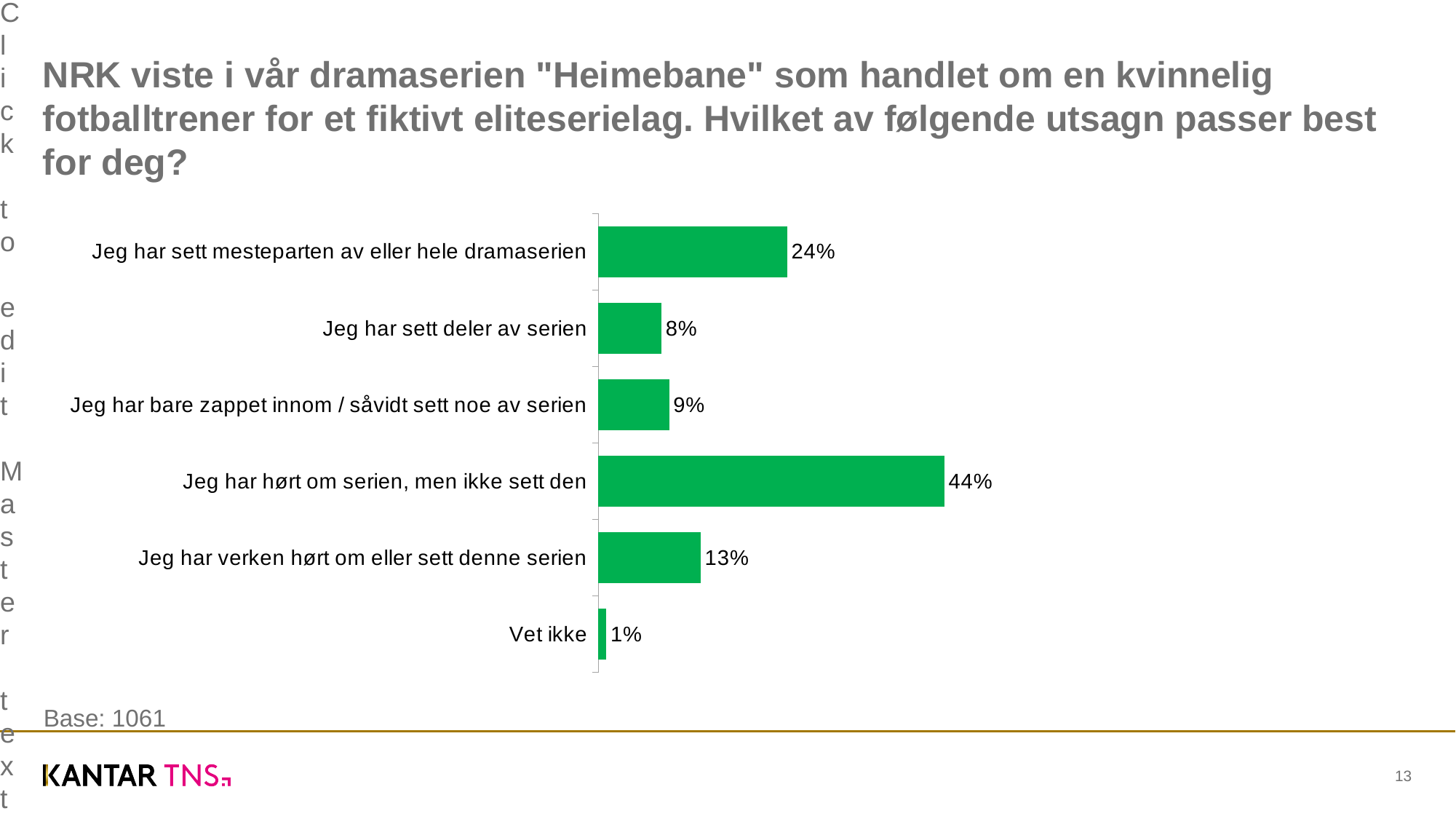
How many categories are shown in the chart? 6 What kind of chart is shown on the slide? Bar chart What is the difference between "Jeg har hørt om serien, men ikke sett den" and "Jeg har sett mesteparten av eller hele dramaserien"? 20 percentage points Which is larger: "Jeg har sett deler av serien" or "Jeg har bare zappet innom / såvidt sett noe av serien"? Jeg har bare zappet innom / såvidt sett noe av serien What percentage of respondents said "Jeg har verken hørt om eller sett denne serien"? 13% Which statement has the lowest share of respondents? Vet ikke Which statement has the highest share of respondents? Jeg har hørt om serien, men ikke sett den What is the base (number of respondents) stated below the chart? 1061 What percentage of respondents said "Jeg har sett mesteparten av eller hele dramaserien"? 24% What is the value for "Vet ikke"? 1% What is the value for "Jeg har sett deler av serien"? 8% What is the value for "Jeg har bare zappet innom / såvidt sett noe av serien"? 9%